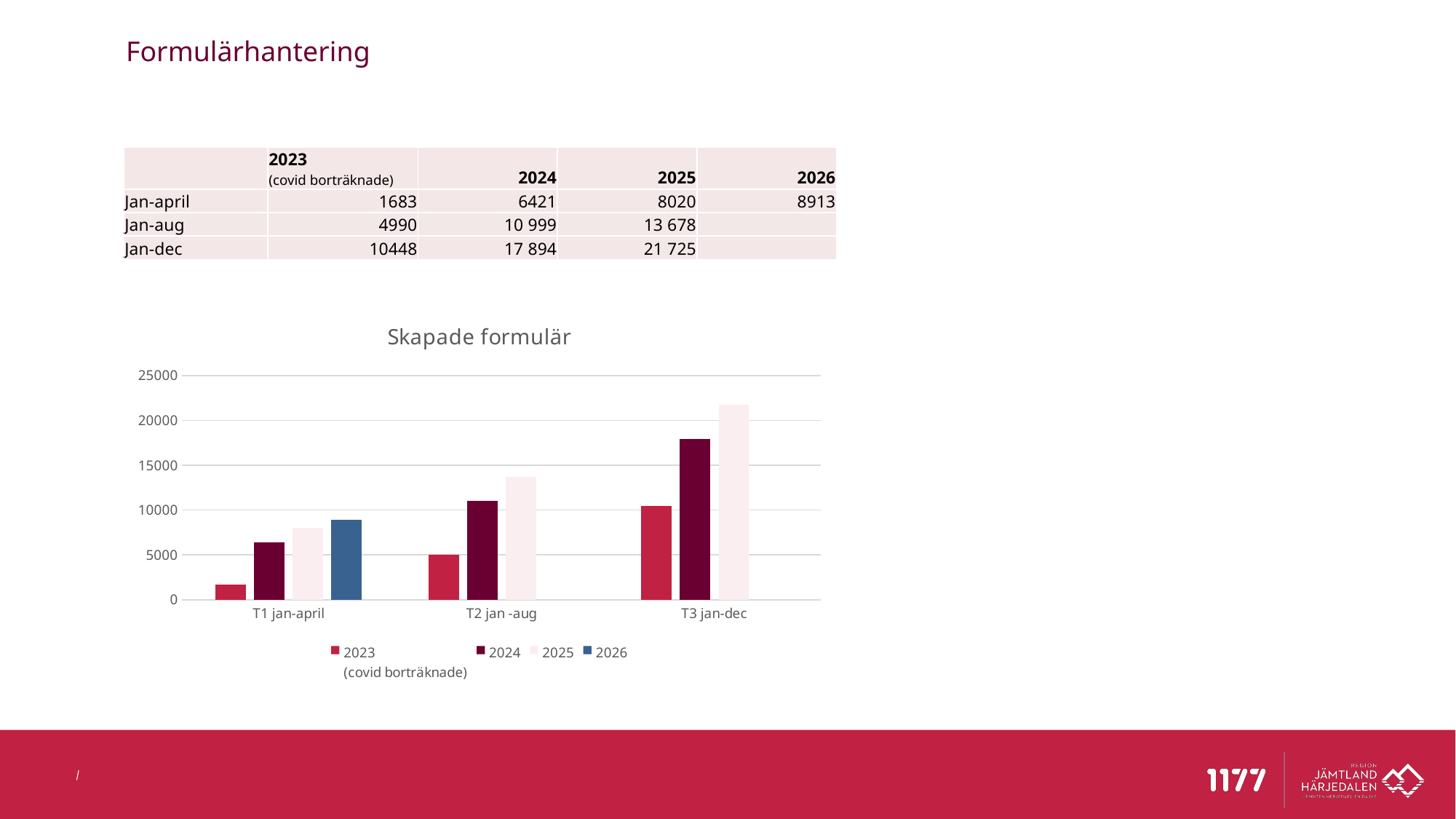
In the "Skapade formulär" chart, which series appears only in the T1 jan-april group? 2026 In the "Skapade formulär" chart, which is larger: the 2024 bar for T3 jan-dec or the 2025 bar for T2 jan -aug? 2024 bar for T3 jan-dec In the "Skapade formulär" chart, which series has the lowest bar in the T1 jan-april group? 2023 (covid borträknade) In the "Skapade formulär" chart, is the 2025 value for T3 jan-dec greater or less than 20000? greater How many categories are shown on the x axis of the "Skapade formulär" chart? 3 In the "Skapade formulär" chart, do the 2025 bars rise or fall from T1 jan-april to T3 jan-dec? rise In the "Skapade formulär" chart, is the 2023 value for T3 jan-dec greater or less than 15000? less What kind of chart is shown under the title "Skapade formulär"? bar chart According to the slide, what is the 2026 value for Jan-april? 8913 According to the slide, what is the difference between the 2025 and 2024 values for Jan-dec? 3831 How many series does the legend of the "Skapade formulär" chart list? 4 In the "Skapade formulär" chart, which category has the tallest 2025 bar? T3 jan-dec